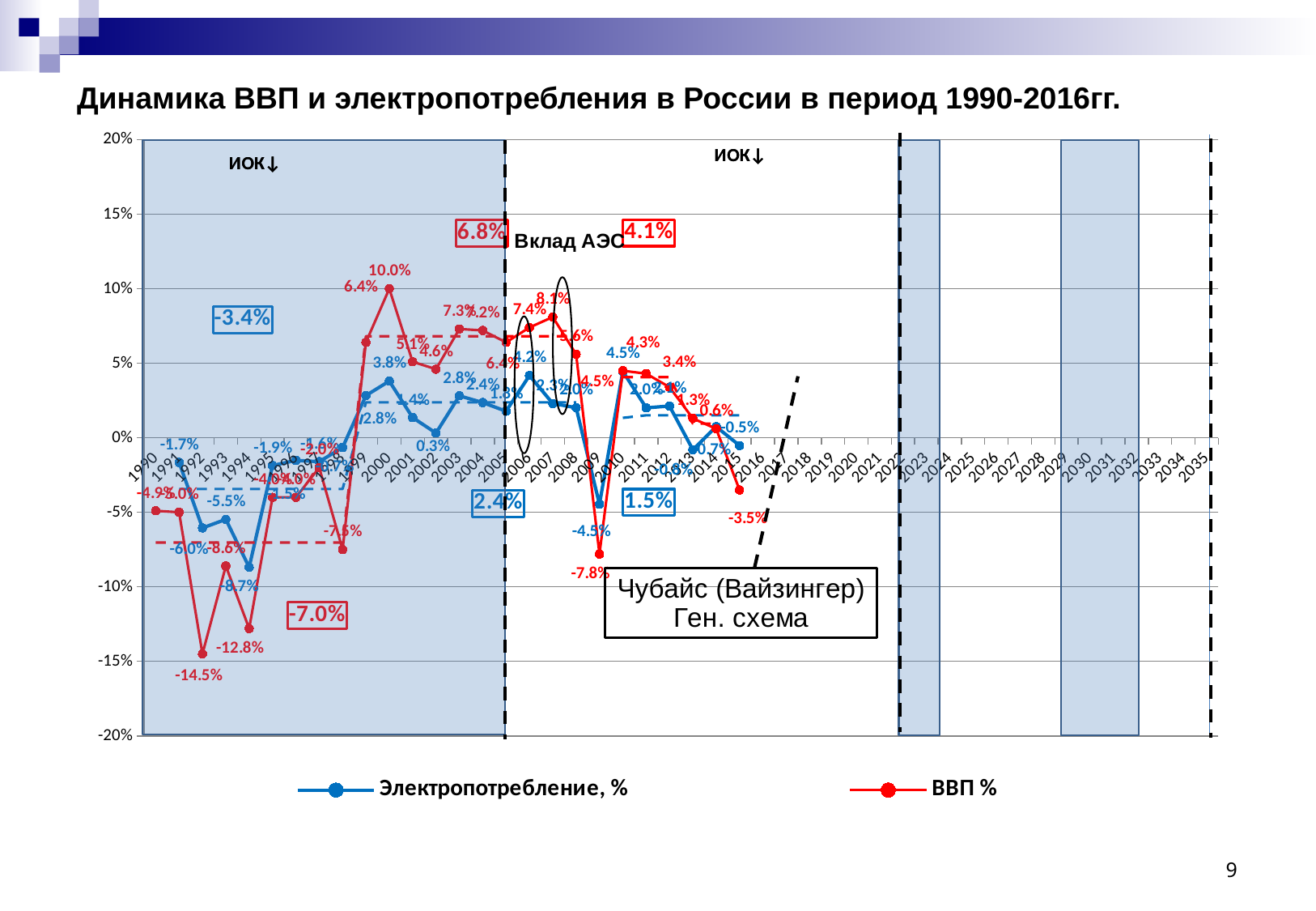
In which year does the ВВП % series reach its lowest value? 1992 What is the ВВП % value for 2009? -7.8% In 1992, which is larger: the ВВП % value or the Электропотребление, % value? Электропотребление, % What is the Электропотребление, % value for 2000? 3.8% What kind of chart is shown on the slide? line chart What are the two series named in the legend? Электропотребление, % and ВВП % What is the ВВП % value for 2000? 10.0% How many series does the legend list? 2 In which year does the ВВП % series reach its highest value? 2000 What is the difference between ВВП % and Электропотребление, % in 2000? 6.2 percentage points What is the ВВП % value for 1992? -14.5% Is the ВВП % value for 2009 greater or less than -5%? less